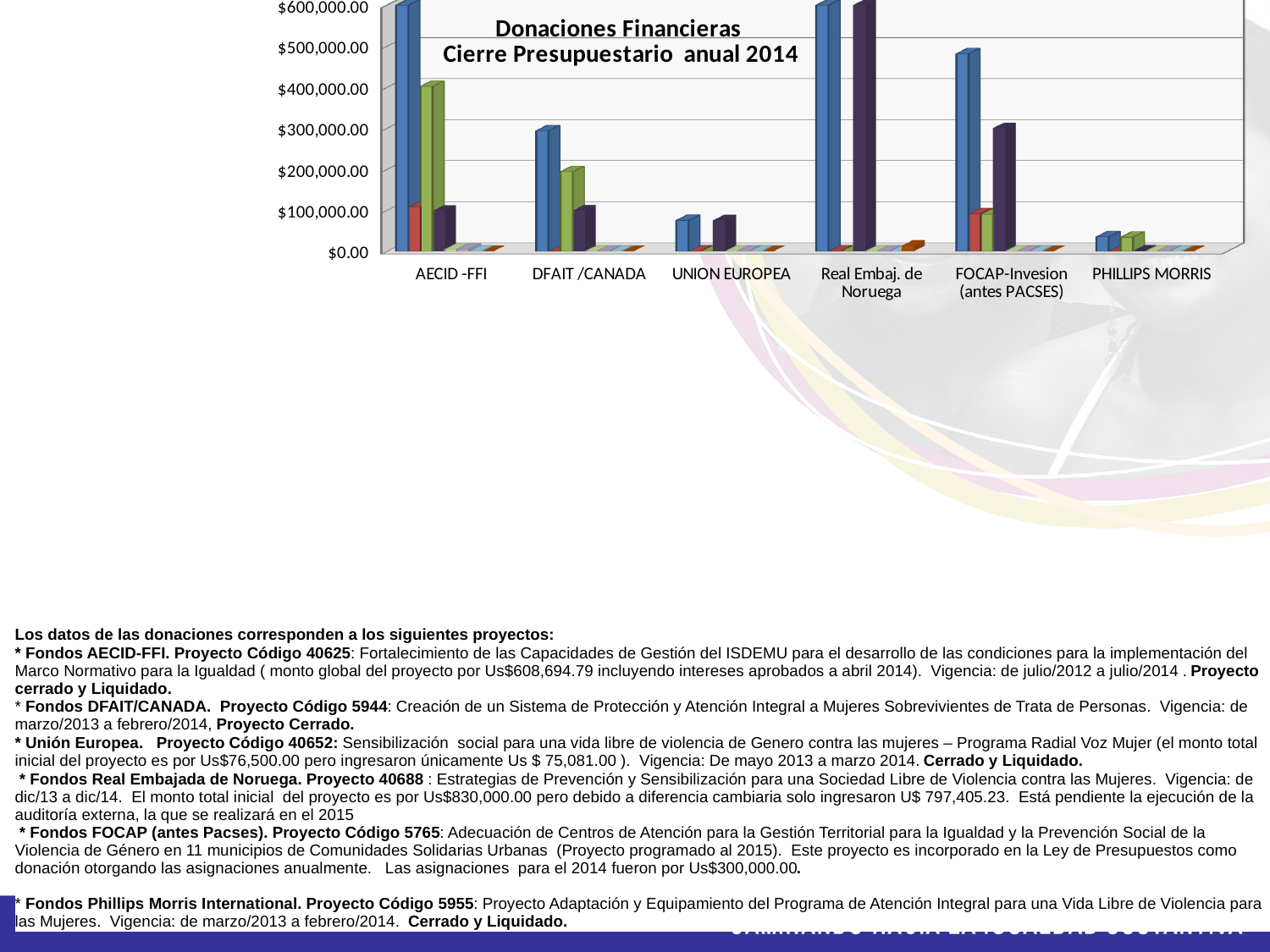
Is the green bar for AECID -FFI greater or less than $300,000.00? greater Which has the larger blue bar, DFAIT /CANADA or FOCAP-Invesion (antes PACSES)? FOCAP-Invesion (antes PACSES) Is the blue bar for DFAIT /CANADA greater or less than $200,000.00? greater Is the blue bar for FOCAP-Invesion (antes PACSES) greater or less than $400,000.00? greater Which has the larger green bar, AECID -FFI or DFAIT /CANADA? AECID -FFI What kind of chart is shown on the slide? bar chart What is the title of the chart? Donaciones Financieras Cierre Presupuestario anual 2014 Which category has the lowest value for the blue (first) bar series? PHILLIPS MORRIS How many donor categories are shown along the x axis of the chart? 6 Which has the larger blue bar, UNION EUROPEA or PHILLIPS MORRIS? UNION EUROPEA